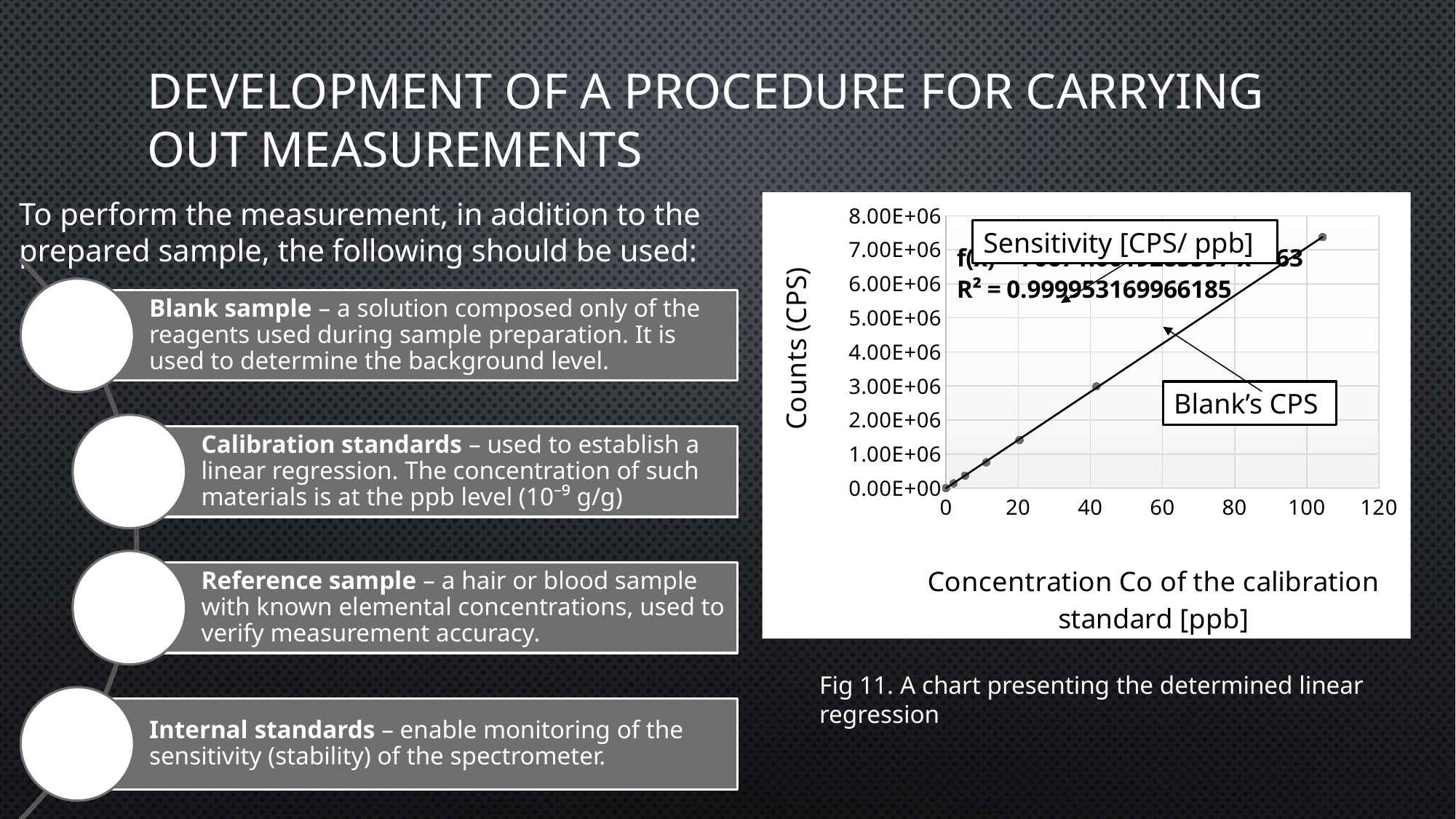
Which point has the highest counts value: the one at about 40 ppb or the one at about 105 ppb? The one at about 105 ppb Is the counts value for the point at about 10 ppb greater or less than 1.00E+06? less Is the counts value for the point at about 20 ppb greater or less than 2.00E+06? less What is the title of the x axis of the chart? Concentration Co of the calibration standard [ppb] What is the maximum value shown on the y axis of the chart? 8.00E+06 What is the R² value shown on the chart? R² = 0.999953169966185 What is the title of the y axis of the chart? Counts (CPS) Do the counts rise or fall as the concentration increases along the x axis? Rise Is the counts value for the point at about 20 ppb greater or less than 1.00E+06? greater What is the maximum value shown on the x axis of the chart? 120 What kind of chart is shown on the slide? Scatter chart with a linear trendline